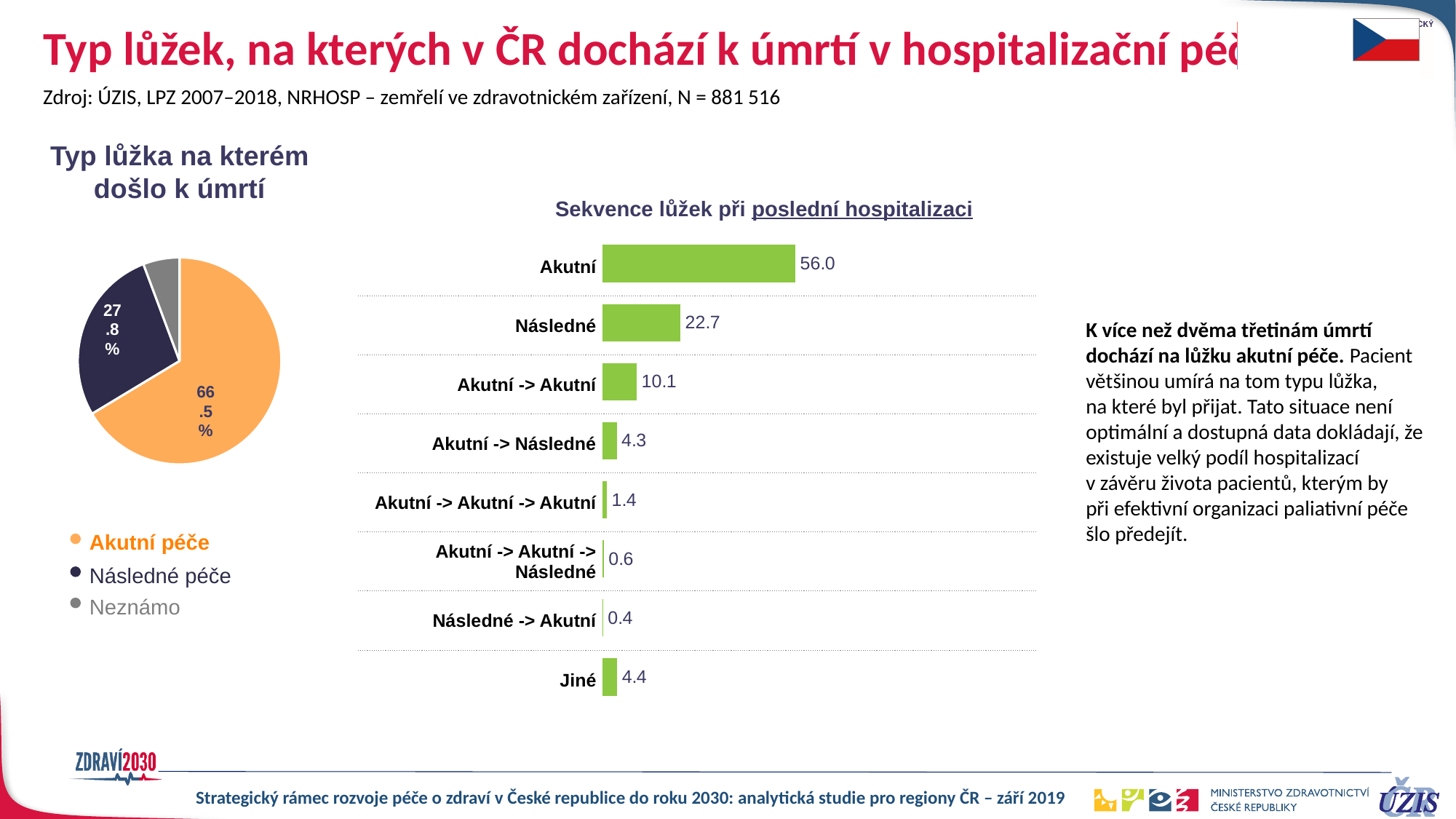
In the pie chart 'Typ lůžka na kterém došlo k úmrtí', what share is labelled for Následné péče? 27.8% In the bar chart 'Sekvence lůžek při poslední hospitalizaci', which is larger: Akutní -> Následné or Jiné? Jiné In the bar chart 'Sekvence lůžek při poslední hospitalizaci', what is the value for Následné? 22.7 In the bar chart 'Sekvence lůžek při poslední hospitalizaci', what is the value for Akutní? 56.0 In the bar chart 'Sekvence lůžek při poslední hospitalizaci', what is the value for Jiné? 4.4 In the bar chart 'Sekvence lůžek při poslední hospitalizaci', which category has the highest value? Akutní In the bar chart 'Sekvence lůžek při poslední hospitalizaci', which category has the lowest value? Následné -> Akutní In the bar chart 'Sekvence lůžek při poslední hospitalizaci', what is the value for Akutní -> Akutní? 10.1 How many categories does the bar chart 'Sekvence lůžek při poslední hospitalizaci' show? 8 In the bar chart 'Sekvence lůžek při poslední hospitalizaci', what is the difference between the values for Akutní and Následné? 33.3 What kind of chart is 'Sekvence lůžek při poslední hospitalizaci'? bar chart In the pie chart 'Typ lůžka na kterém došlo k úmrtí', what share is labelled for Akutní péče? 66.5%